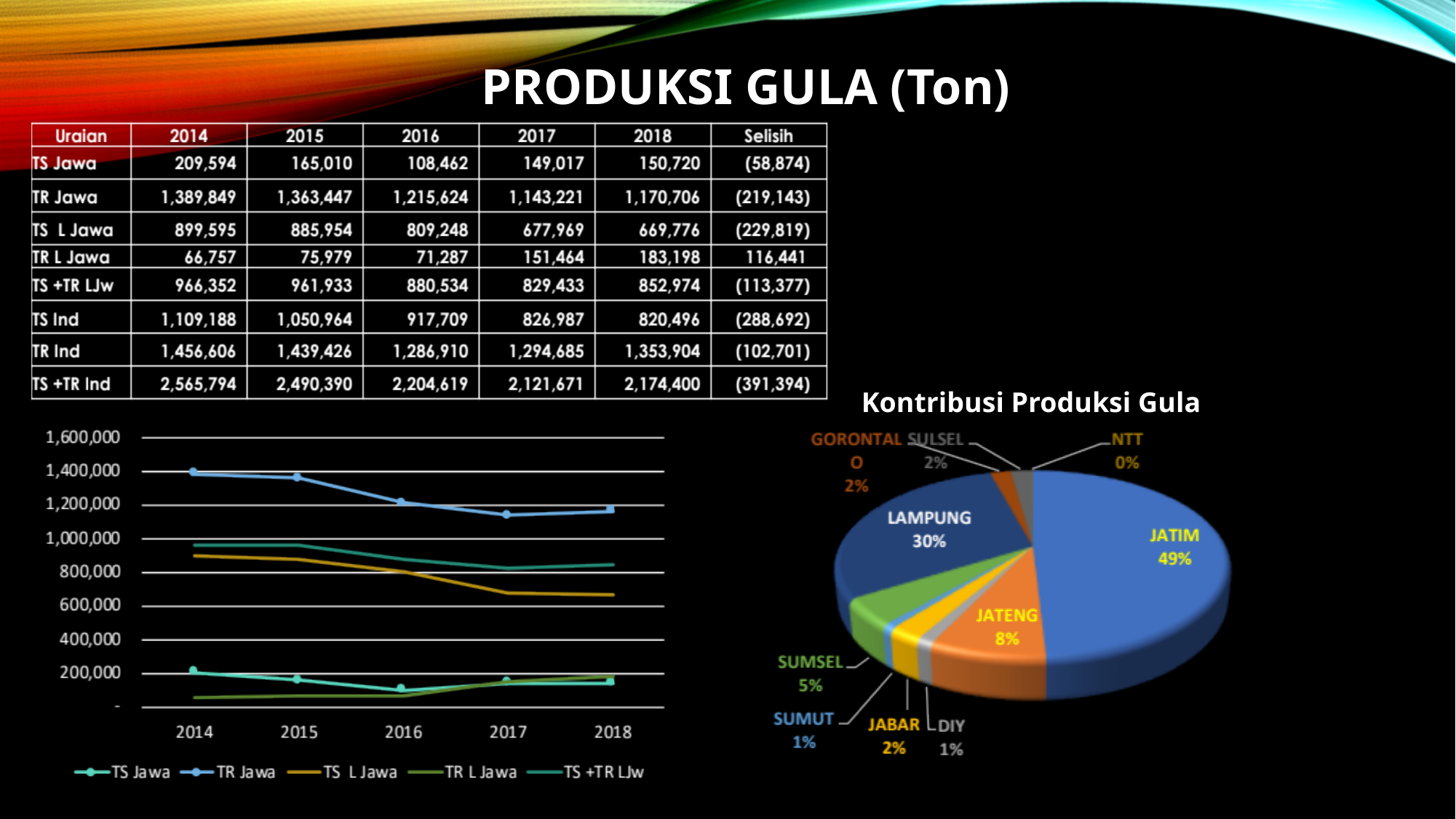
How many series does the legend of the line chart list? 5 In the 'Kontribusi Produksi Gula' pie chart, which region has the largest share? JATIM In the line chart, is the value for TR Jawa in 2014 greater or less than 1,200,000? greater In the 'Kontribusi Produksi Gula' pie chart, what share does LAMPUNG have? 30% What kind of chart is the 'Kontribusi Produksi Gula' chart? pie chart How many years are shown on the x axis of the line chart? 5 What kind of chart is the chart on the left of the slide? line chart In the line chart, is the value for TS L Jawa in 2018 greater or less than 800,000? less In the 'Kontribusi Produksi Gula' pie chart, what is the difference between the shares of JATENG and SUMSEL? 3% In the line chart, which series has the highest values across all years? TR Jawa In the 'Kontribusi Produksi Gula' pie chart, what share does JATIM have? 49% In the line chart, does the TR Jawa series rise or fall from 2014 to 2017? fall